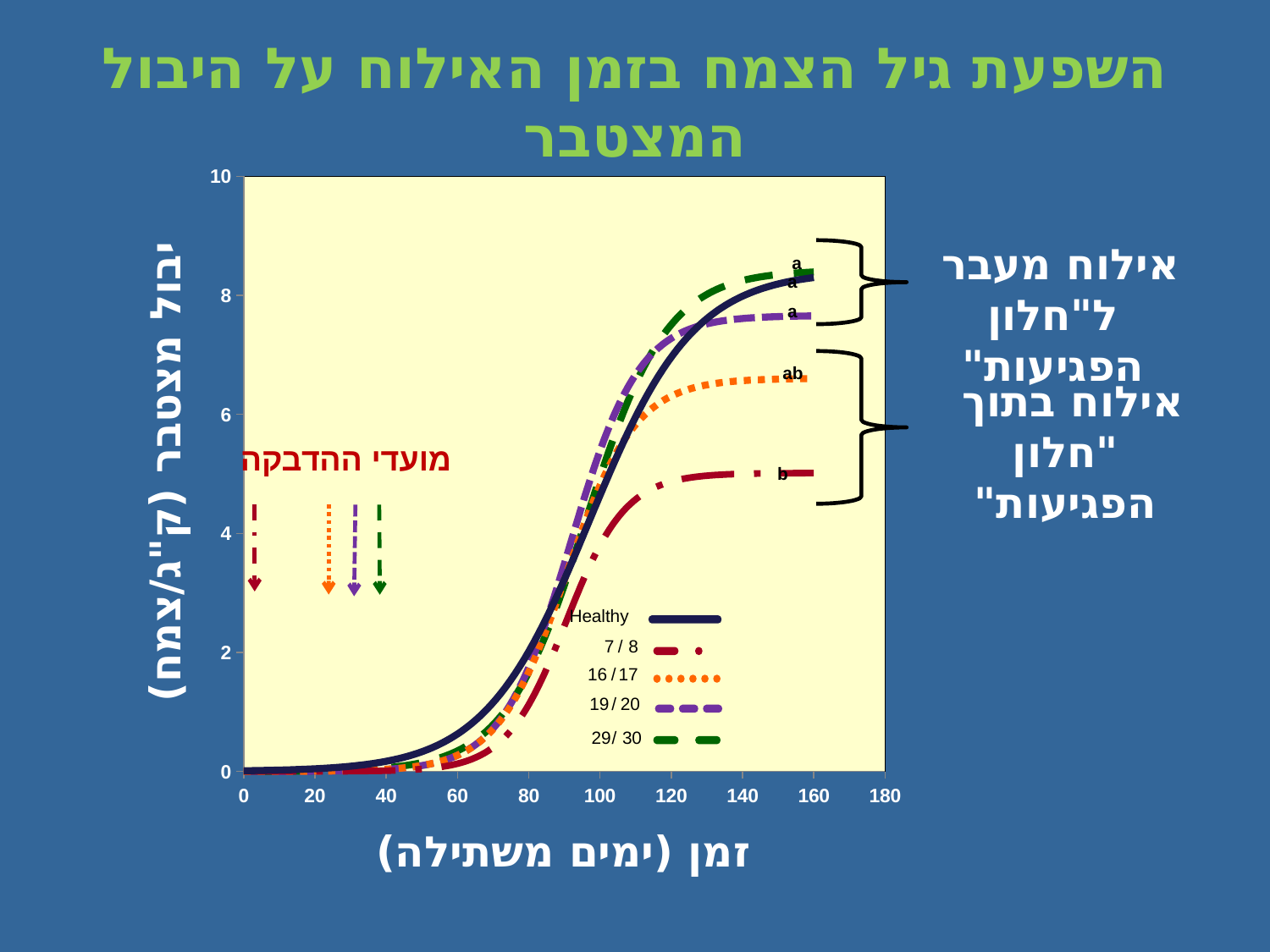
At 160 days, which series has the larger value: 16 / 17 or 7 / 8? 16 / 17 At 160 days, which series has the larger value: 19 / 20 or 16 / 17? 19 / 20 How many series does the chart's legend list? 5 Is the value of the 29 / 30 series at 160 days greater or less than 8? greater Is the value of the 19 / 20 series at 160 days greater or less than 8? less What kind of chart is shown on the slide? line chart Which series has the lowest cumulative yield at 160 days? 7 / 8 Is the value of the 16 / 17 series at 160 days greater or less than 6? greater Do the plotted values rise or fall as time increases along the x axis? rise What is the highest value shown on the x axis of the chart? 180